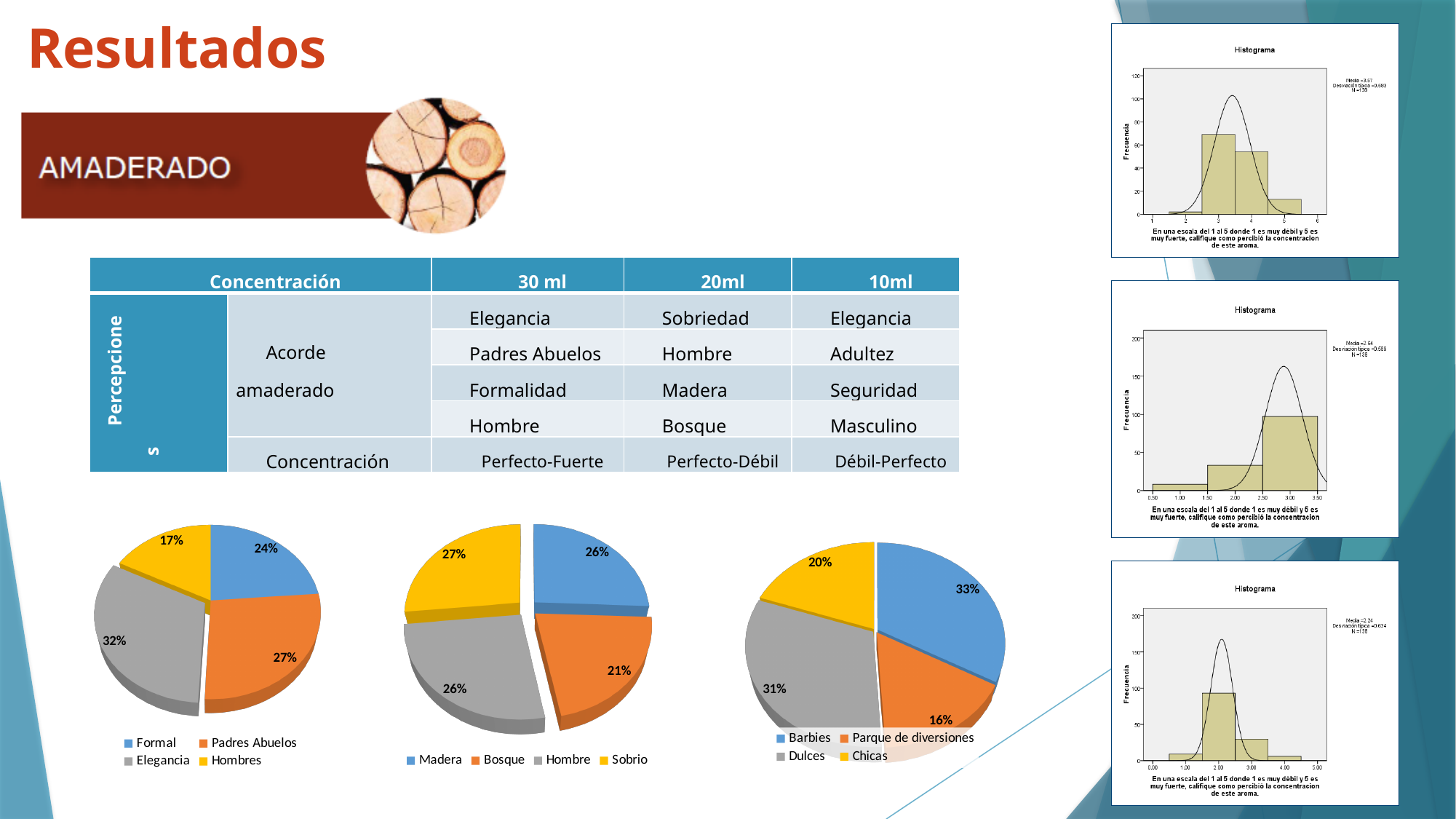
In the middle pie chart at the bottom, what share does Bosque have? 21% In the bottom-left pie chart, which category has the smallest slice? Hombres In the bottom-right pie chart, which category has the largest slice? Barbies In the middle pie chart at the bottom, which category has the smallest slice? Bosque In the bottom-right pie chart, what share does Parque de diversiones have? 16% In the middle pie chart at the bottom, which category has the largest slice? Sobrio How many slices does the bottom-left pie chart have? 4 In the bottom-left pie chart, what share does Elegancia have? 32% In the bottom-left pie chart, which is larger: Formal or Padres Abuelos? Padres Abuelos In the bottom-left pie chart, which category has the largest slice? Elegancia In the bottom-right pie chart, what is the difference between the shares of Barbies and Dulces? 2% What kind of chart is the bottom-left chart? Pie chart